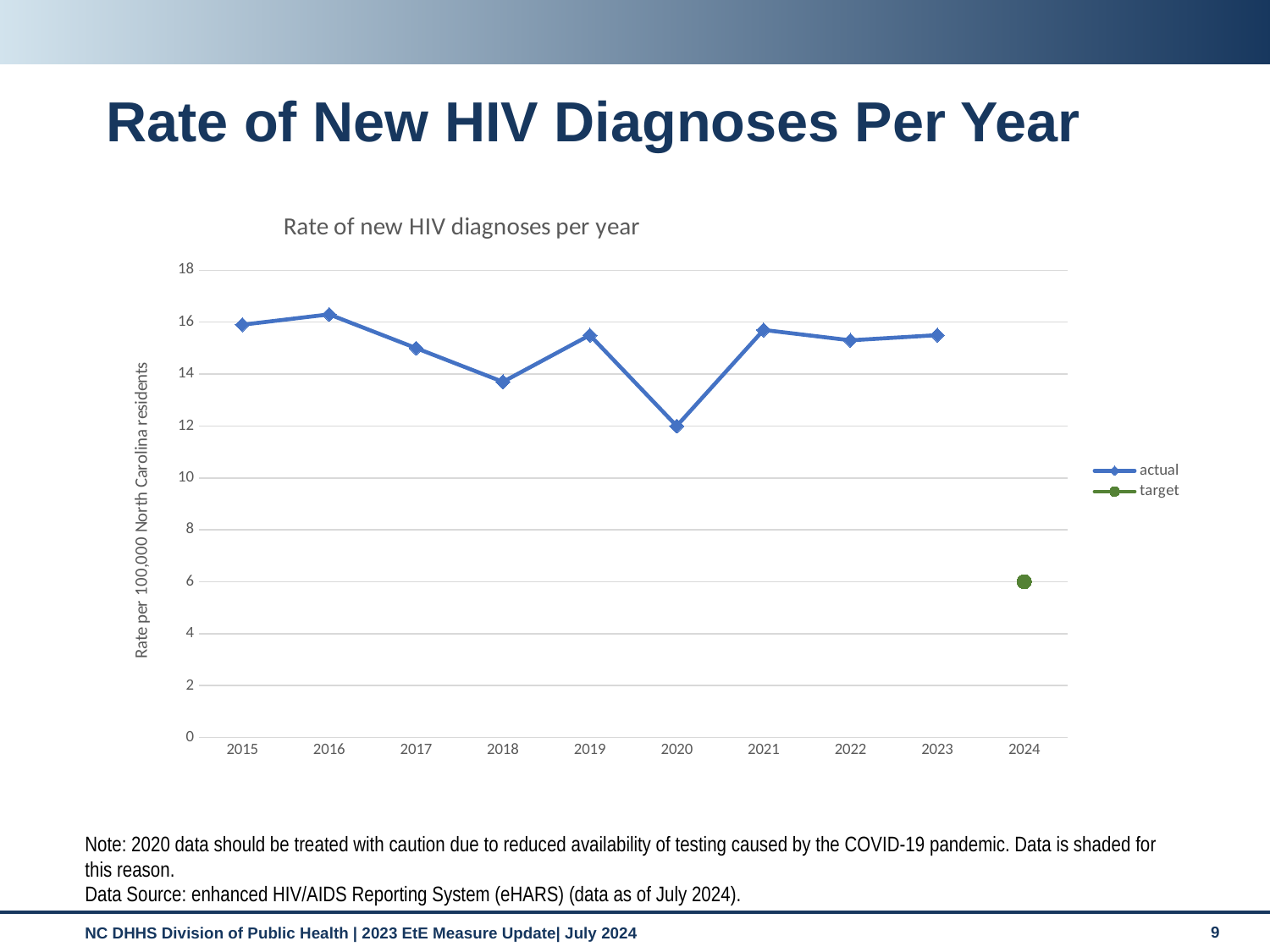
How many years are shown on the x axis? 10 What are the two series named in the legend? actual and target Is the actual value for 2021 greater or less than 16? less In which year is the actual rate of new HIV diagnoses highest? 2016 How many series does the legend list? 2 Which year has a higher actual rate, 2019 or 2020? 2019 What is the target value plotted for 2024? 6 Does the actual rate rise or fall from 2019 to 2020? fall Is the actual value for 2018 greater or less than 14? less In which year is the actual rate of new HIV diagnoses lowest? 2020 What type of chart is shown on the slide? line chart Is the actual value for 2016 greater or less than 16? greater